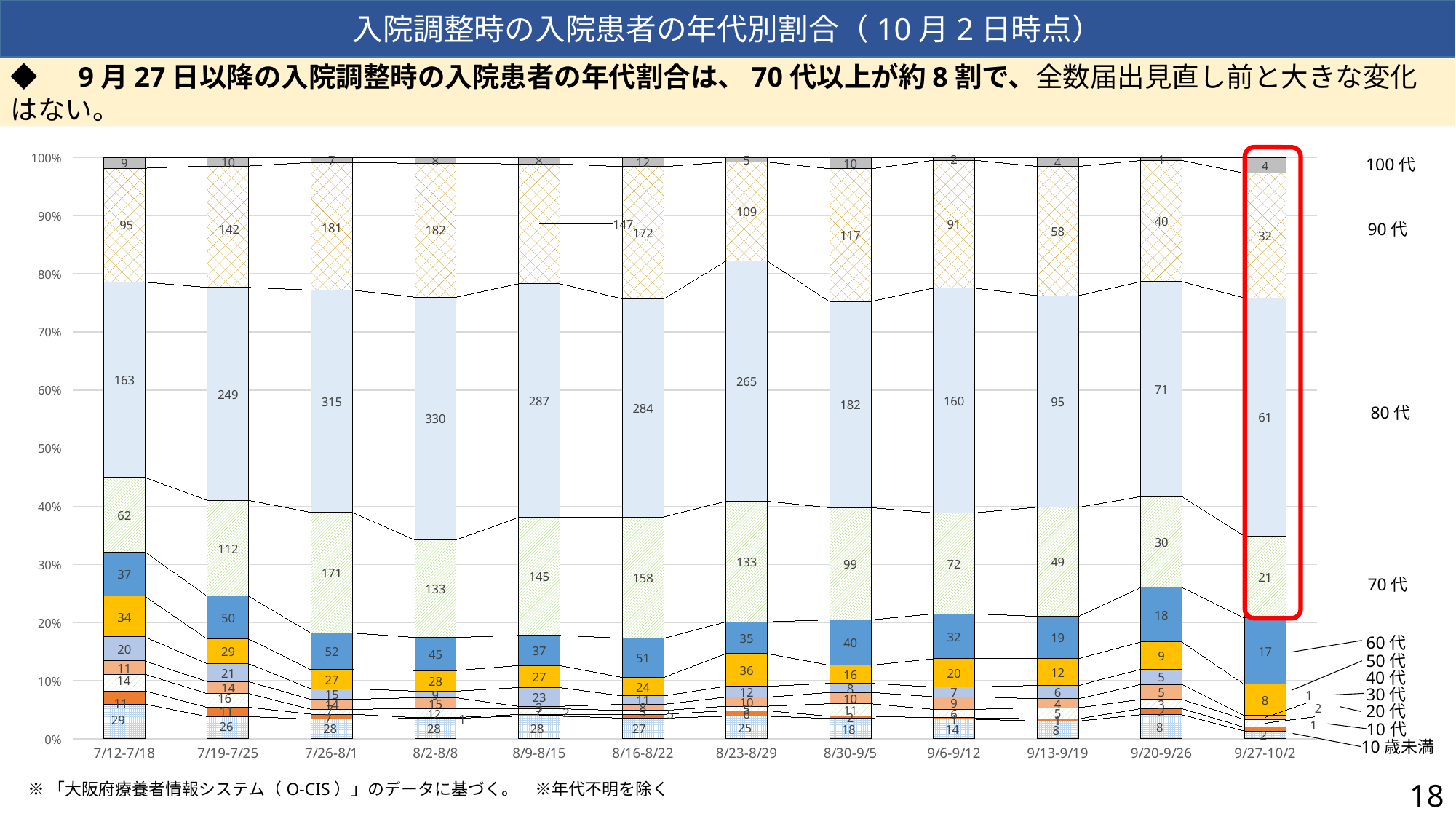
What is the difference between the 80代 value in 8/2-8/8 and the 80代 value in 9/27-10/2? 269 What is the value for 80代 in the 9/27-10/2 period? 61 How many weekly periods are shown on the x axis? 12 Across all periods, in which period is the 80代 value highest? 8/2-8/8 What is the value for 80代 in the 8/2-8/8 period? 330 Across all periods, in which period is the 70代 value highest? 7/26-8/1 What is the value for 70代 in the 9/27-10/2 period? 21 What kind of chart is shown on the slide? Stacked bar chart In the 9/27-10/2 period, which is larger, the 80代 value or the 70代 value? 80代 In the 9/27-10/2 bar, is the top of the 70代 segment above or below the 30% line? above From 8/23-8/29 to 9/27-10/2, does the 80代 value rise or fall? fall What is the value for 90代 in the 7/26-8/1 period? 181